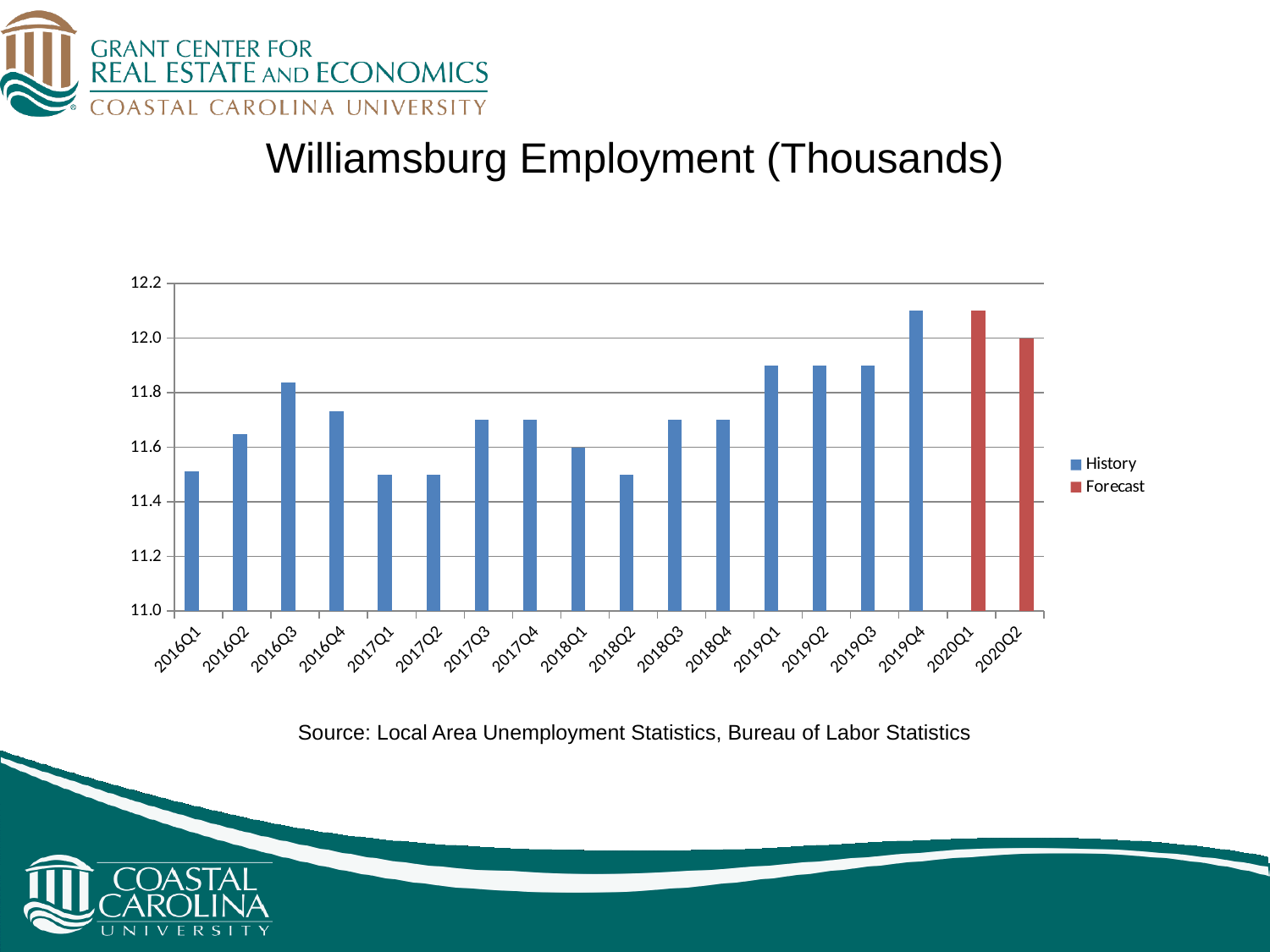
How many quarters are shown on the x axis of the chart? 18 How many series does the legend list? 2 Which is larger, the value for 2016Q3 or the value for 2016Q1? 2016Q3 What are the two series named in the legend? History and Forecast What kind of chart is shown on the slide? bar chart Is the value for 2019Q4 greater or less than 12.0? greater Is the value for 2019Q1 greater or less than 11.8? greater Is the value for 2016Q1 greater or less than 11.6? less Do the values rise or fall from 2018Q2 to 2019Q4? rise Which quarters are shown as Forecast (red) bars? 2020Q1 and 2020Q2